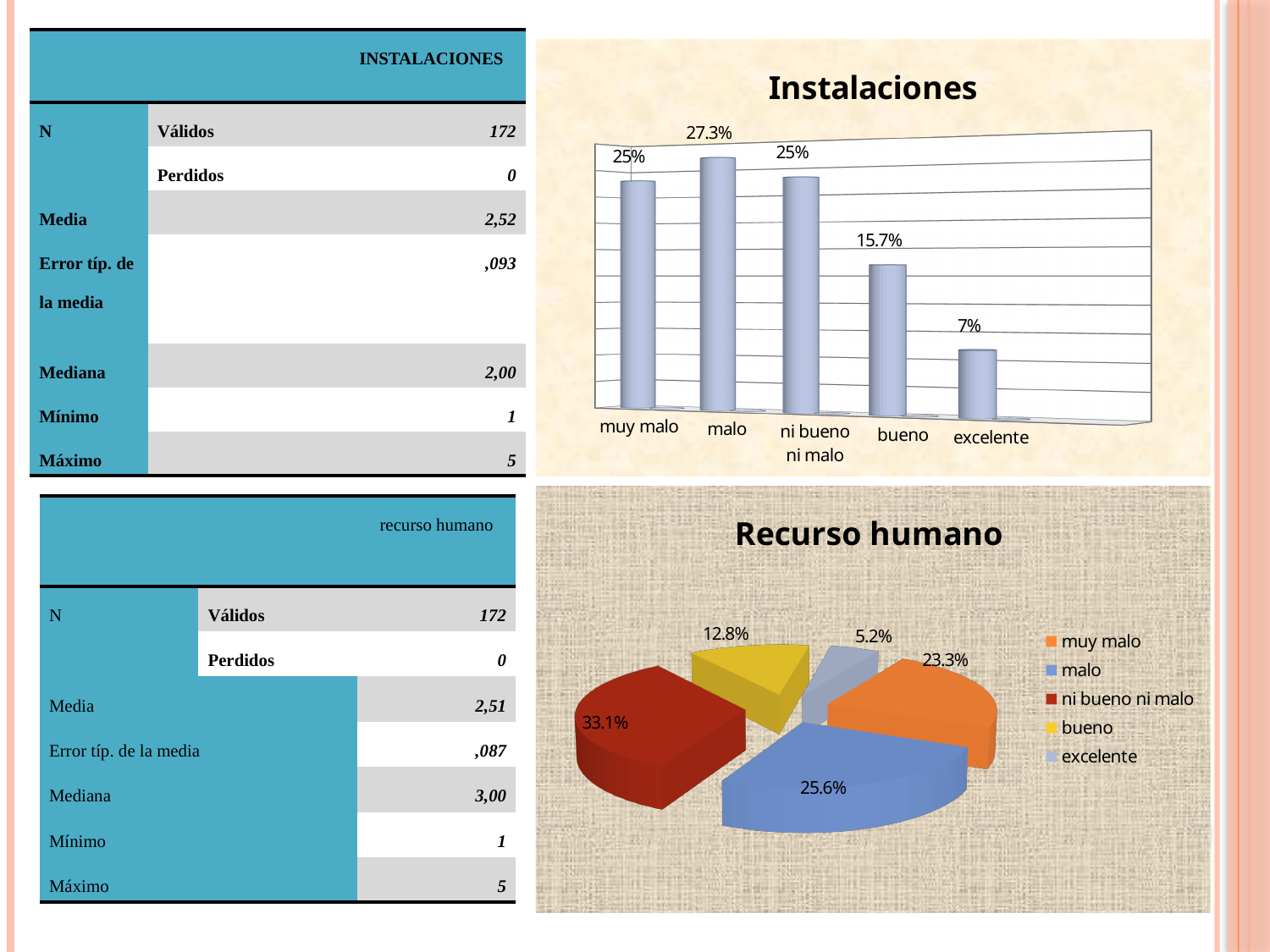
In the Instalaciones chart, what is the difference between the values for bueno and excelente? 8.7% What kind of chart is the Instalaciones chart? bar chart In the Instalaciones chart, what is the value for bueno? 15.7% In the Recurso humano chart, which is larger, muy malo or malo? malo In the Instalaciones chart, which category has the lowest value? excelente How many entries does the legend of the Recurso humano chart list? 5 In the Recurso humano chart, what share does ni bueno ni malo have? 33.1% In the Instalaciones chart, how many categories are shown on the x axis? 5 In the Instalaciones chart, which category has the highest value? malo What kind of chart is the Recurso humano chart? pie chart In the Instalaciones chart, what is the value for malo? 27.3% In the Recurso humano chart, what is the value for excelente? 5.2%